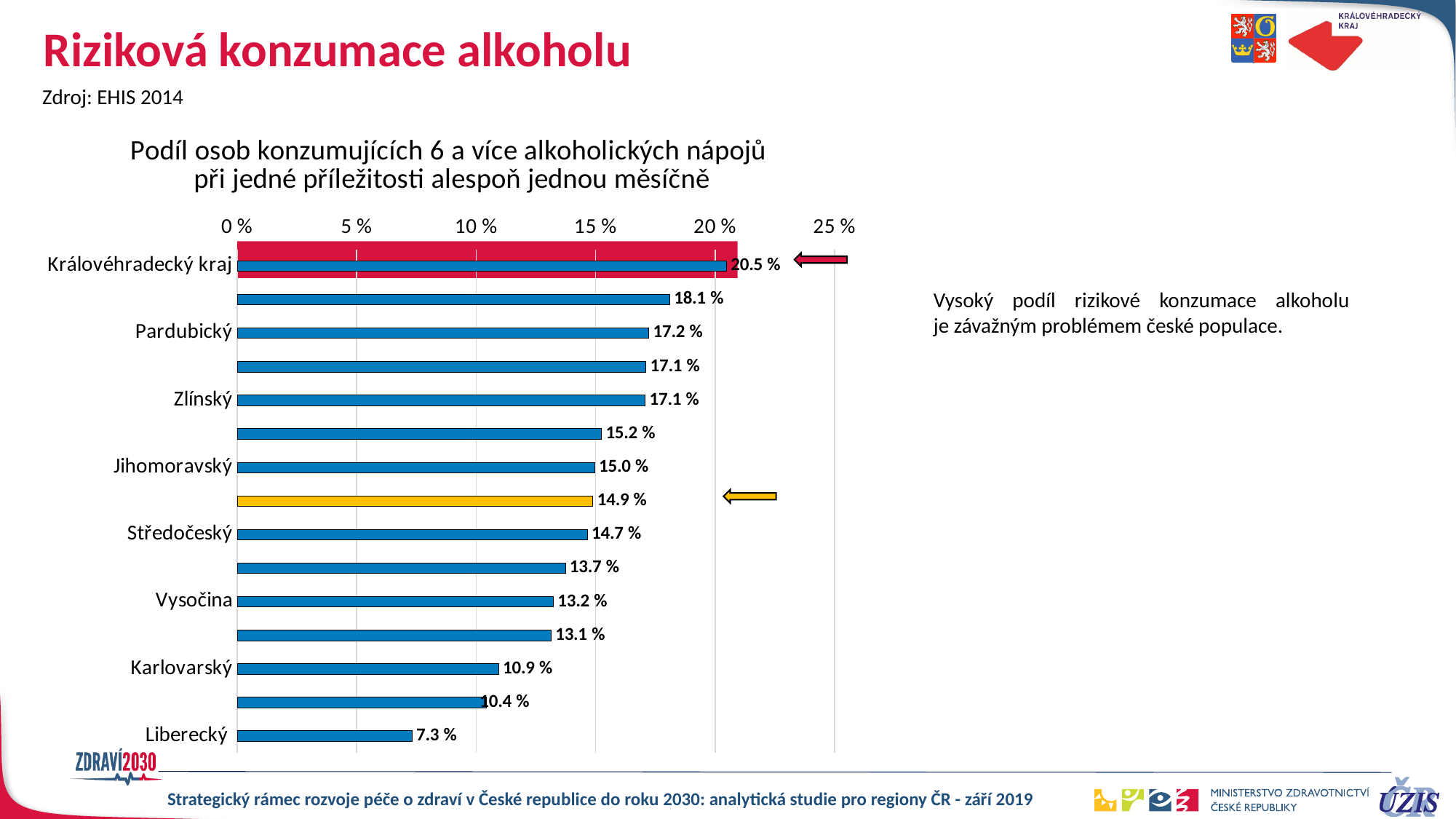
Which is larger, the value for Zlínský or the value for Vysočina? Zlínský What is the value for Královéhradecký kraj? 20.5 % What kind of chart is shown on the slide? bar chart Which category has the lowest value? Liberecký Is the value for Jihomoravský greater or less than 10 %? greater What is the value for Liberecký? 7.3 % Which category has the highest value? Královéhradecký kraj What is the value of the yellow bar? 14.9 % What is the value for Pardubický? 17.2 % What is the value for Karlovarský? 10.9 % How many bars are plotted in the chart? 15 What is the difference between the values for Královéhradecký kraj and Liberecký? 13.2 %